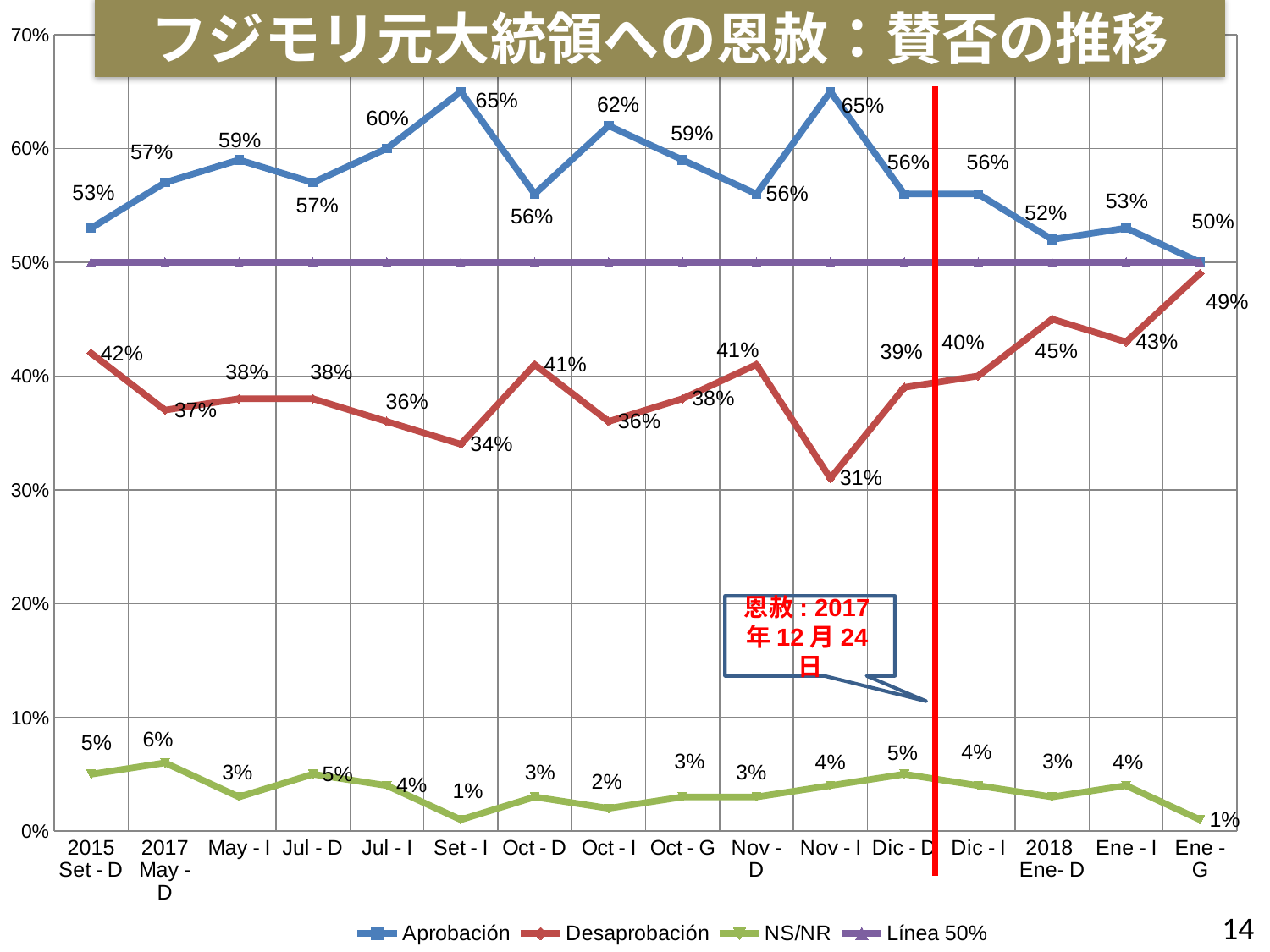
At which category is Desaprobación highest? Ene - G What is the name of the series drawn as a flat line at 50%? Línea 50% At which category is Aprobación lowest? Ene - G How many categories are shown on the x axis? 16 Which is larger at Set - I, Aprobación or Desaprobación? Aprobación What is the NS/NR value for 2017 May - D? 6% What is the Aprobación value for Oct - I? 62% At which category is Desaprobación lowest? Nov - I What is the difference between Aprobación and Desaprobación at 2018 Ene - D? 7% What type of chart is shown on the slide? line chart What is the Desaprobación value for Nov - I? 31% How many series does the legend list? 4